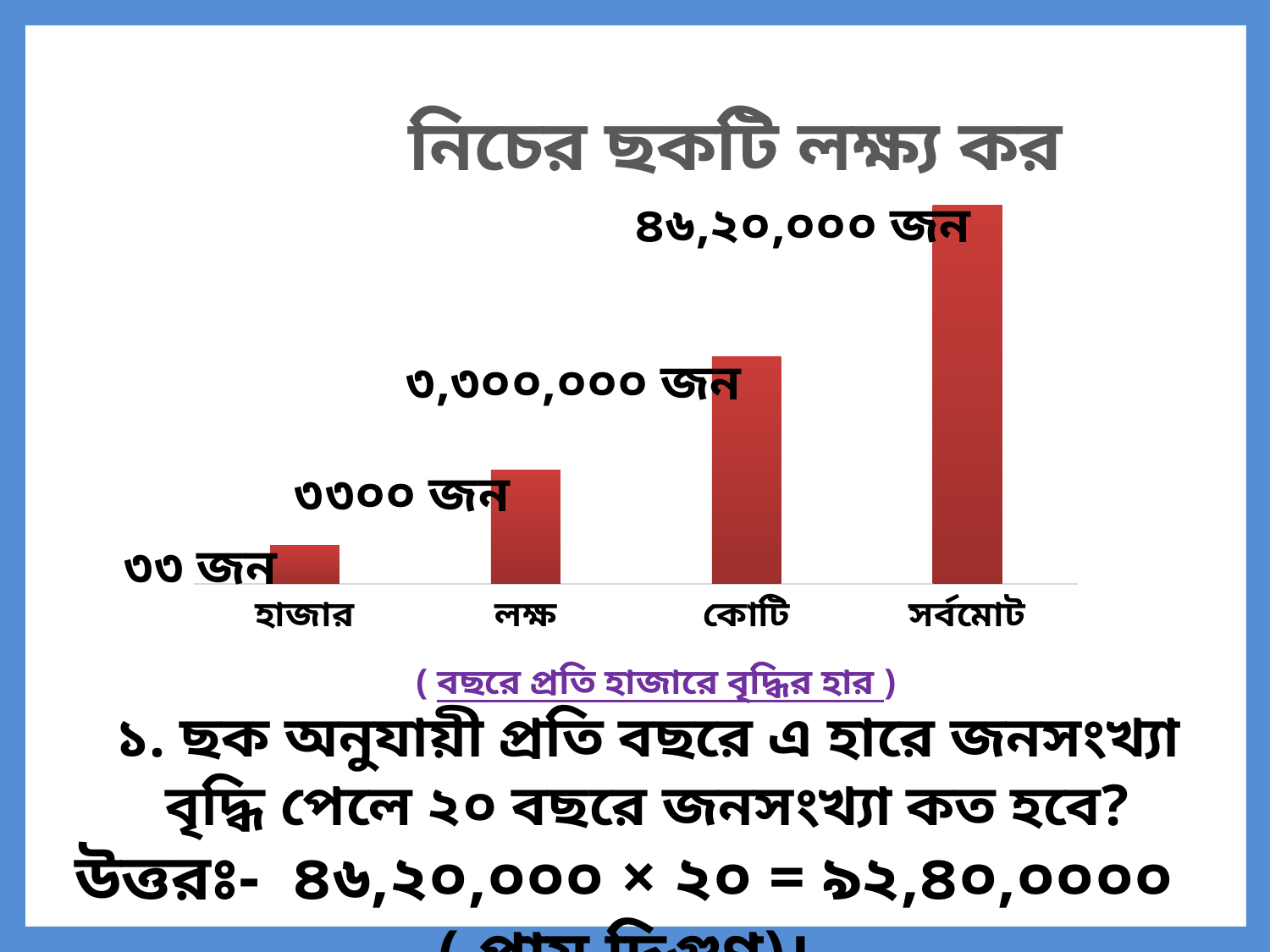
What kind of chart is shown on the slide? bar chart Which is larger, the value for কোটি or the value for লক্ষ? কোটি What is the value shown for কোটি? ৩,৩০০,০০০ জন What colour are the bars in the chart? red What is the value shown for সর্বমোট? ৪৬,২০,০০০ জন Which category has the highest value? সর্বমোট Do the values rise or fall from হাজার to সর্বমোট along the x axis? rise What is the value shown for হাজার? ৩৩ জন Which category has the lowest value? হাজার What is the value shown for লক্ষ? ৩৩০০ জন What is the title shown above the chart? নিচের ছকটি লক্ষ্য কর How many categories are shown on the x axis? 4